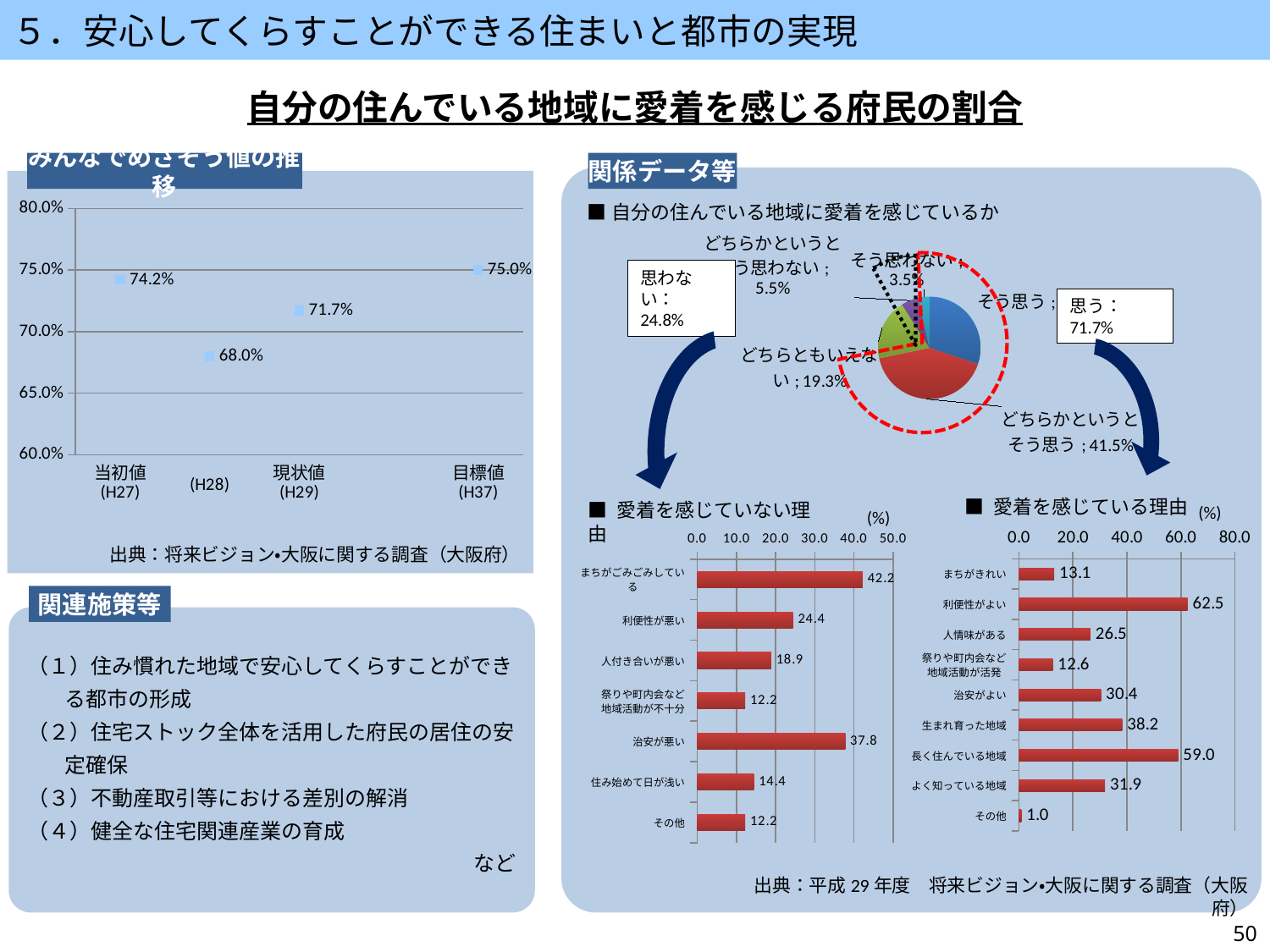
In the pie chart 「自分の住んでいる地域に愛着を感じているか」, what is the share for どちらともいえない? 19.3% In the pie chart 「自分の住んでいる地域に愛着を感じているか」, what is the share for どちらかというとそう思う? 41.5% In the chart 「愛着を感じている理由」, what is the difference between 長く住んでいる地域 and 生まれ育った地域? 20.8 What kind of chart is 「愛着を感じている理由」? bar chart In the chart 「愛着を感じていない理由」, how many categories are shown? 7 In the chart 「みんなでめざそう値の推移」, what is the difference between the 現状値 (H29) and the 目標値 (H37)? 3.3% In the chart 「愛着を感じている理由」, which category has the highest value? 利便性がよい In the chart 「みんなでめざそう値の推移」, what is the value for 当初値 (H27)? 74.2% In the chart 「みんなでめざそう値の推移」, which point has the lowest value? (H28) In the chart 「愛着を感じていない理由」, which category has the highest value? まちがごみごみしている In the chart 「愛着を感じていない理由」, what is the value for 治安が悪い? 37.8 In the chart 「みんなでめざそう値の推移」, what is the value for 目標値 (H37)? 75.0%